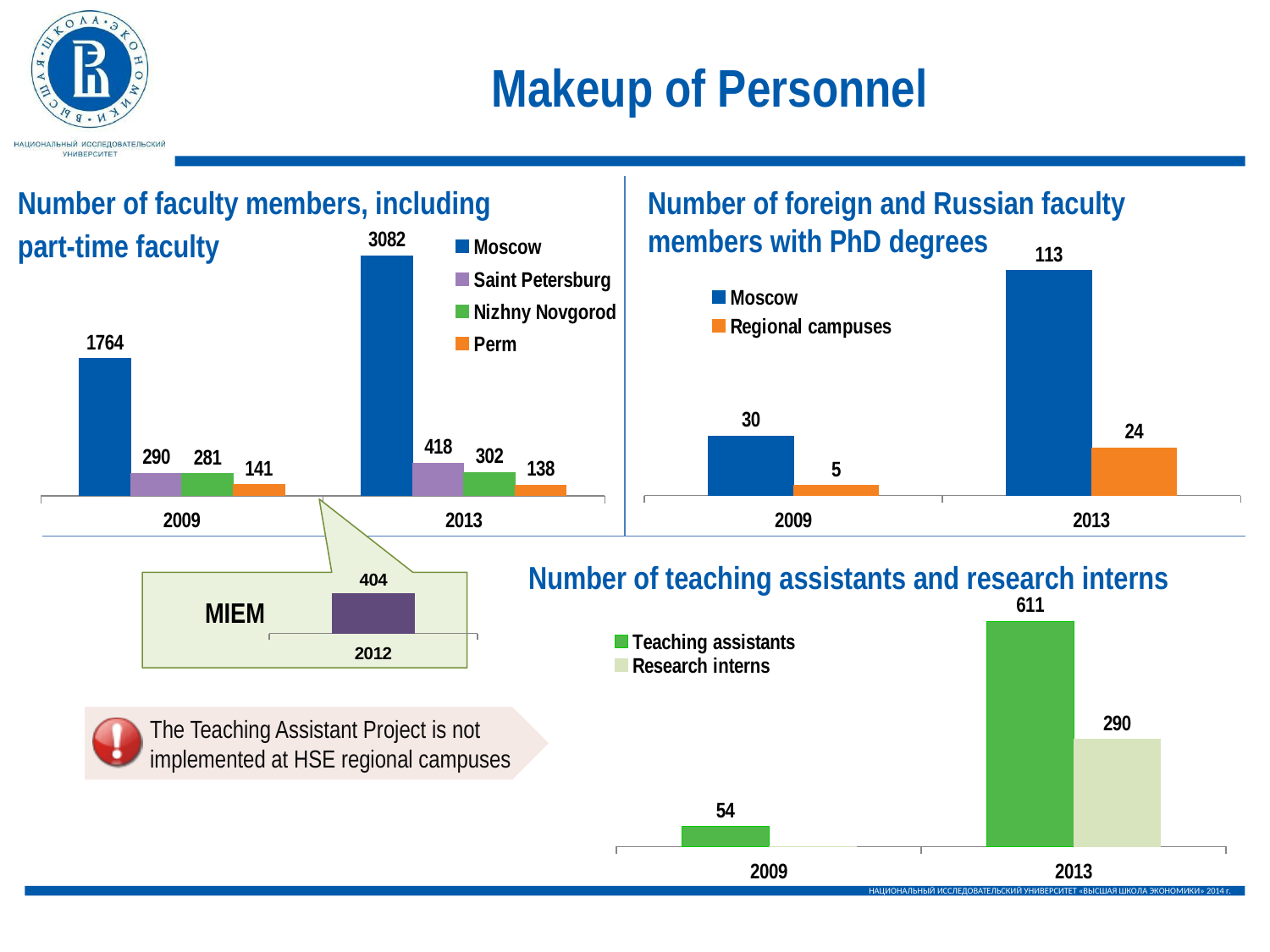
In the 'Number of foreign and Russian faculty members with PhD degrees' chart, what is the difference between Moscow and Regional campuses in 2013? 89 In the 'Number of faculty members, including part-time faculty' chart, what is the difference between the Moscow values for 2013 and 2009? 1318 In the 'Number of foreign and Russian faculty members with PhD degrees' chart, what is the value for Regional campuses in 2013? 24 What kind of chart is the 'Number of teaching assistants and research interns' chart? bar chart In the 'Number of faculty members, including part-time faculty' chart, which campus has the lowest value in 2013? Perm In the 'Number of faculty members, including part-time faculty' chart, what is the value for Moscow in 2013? 3082 In the 'Number of faculty members, including part-time faculty' chart, how many series does the legend list? 4 In the MIEM inset chart, what is the value shown for 2012? 404 In the 'Number of teaching assistants and research interns' chart, what is the value for Research interns in 2013? 290 In the 'Number of foreign and Russian faculty members with PhD degrees' chart, what is the value for Moscow in 2009? 30 In the 'Number of faculty members, including part-time faculty' chart, what is the value for Perm in 2009? 141 In the 'Number of teaching assistants and research interns' chart, does the Teaching assistants value rise or fall from 2009 to 2013? rise